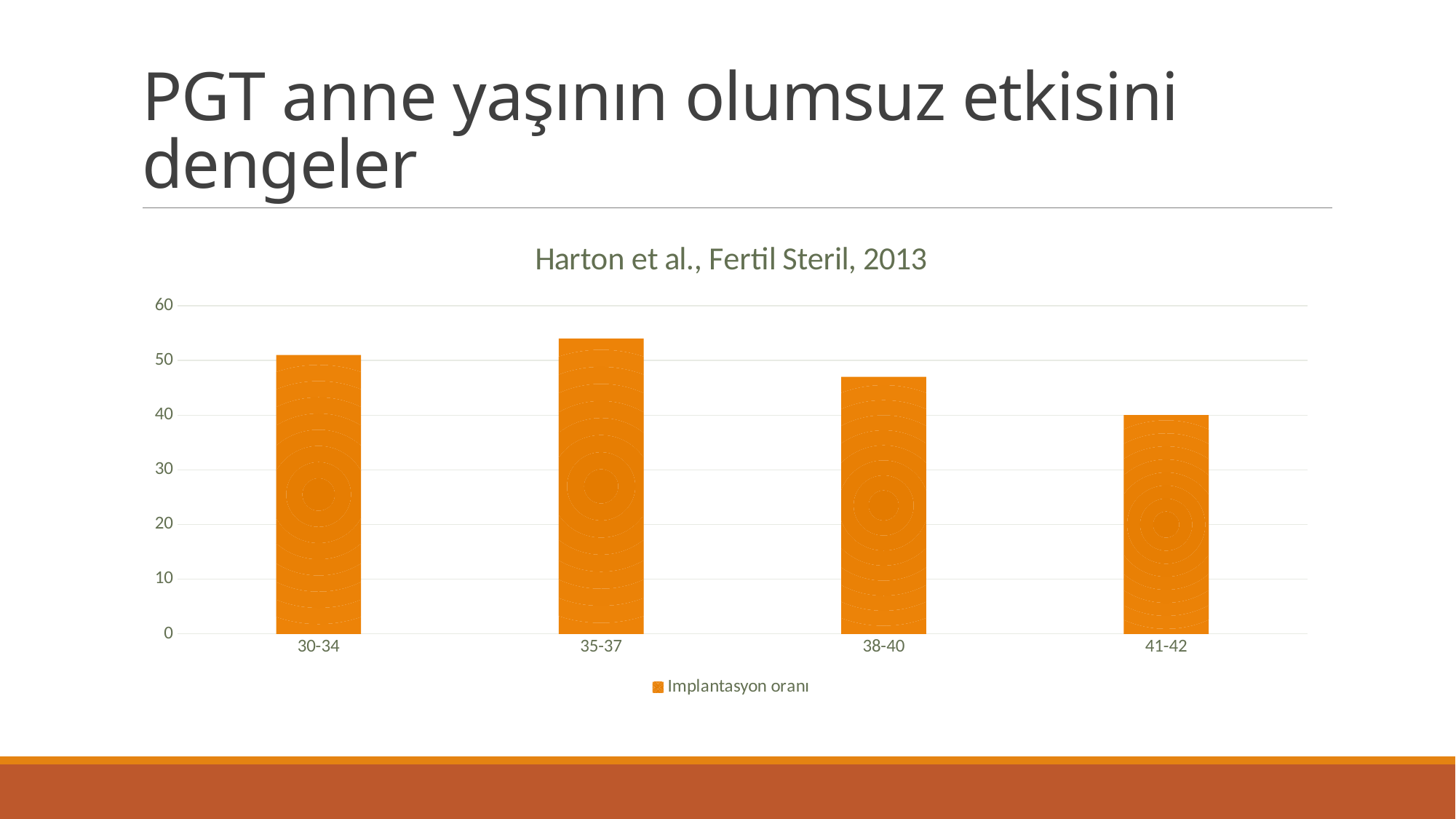
Which is larger, the value for 30-34 or the value for 41-42? 30-34 Which age group has the highest implantation rate? 35-37 What kind of chart is shown on the slide? bar chart What series name does the legend show? Implantasyon oranı How many series does the legend list? 1 Is the value for 35-37 greater or less than 50? greater Which is larger, the value for 35-37 or the value for 38-40? 35-37 Which age group has the lowest implantation rate? 41-42 How many age-group categories are shown on the x axis? 4 Is the value for 38-40 greater or less than 50? less What is the title of the chart? Harton et al., Fertil Steril, 2013 From 35-37 to 41-42, do the values rise or fall along the x axis? fall